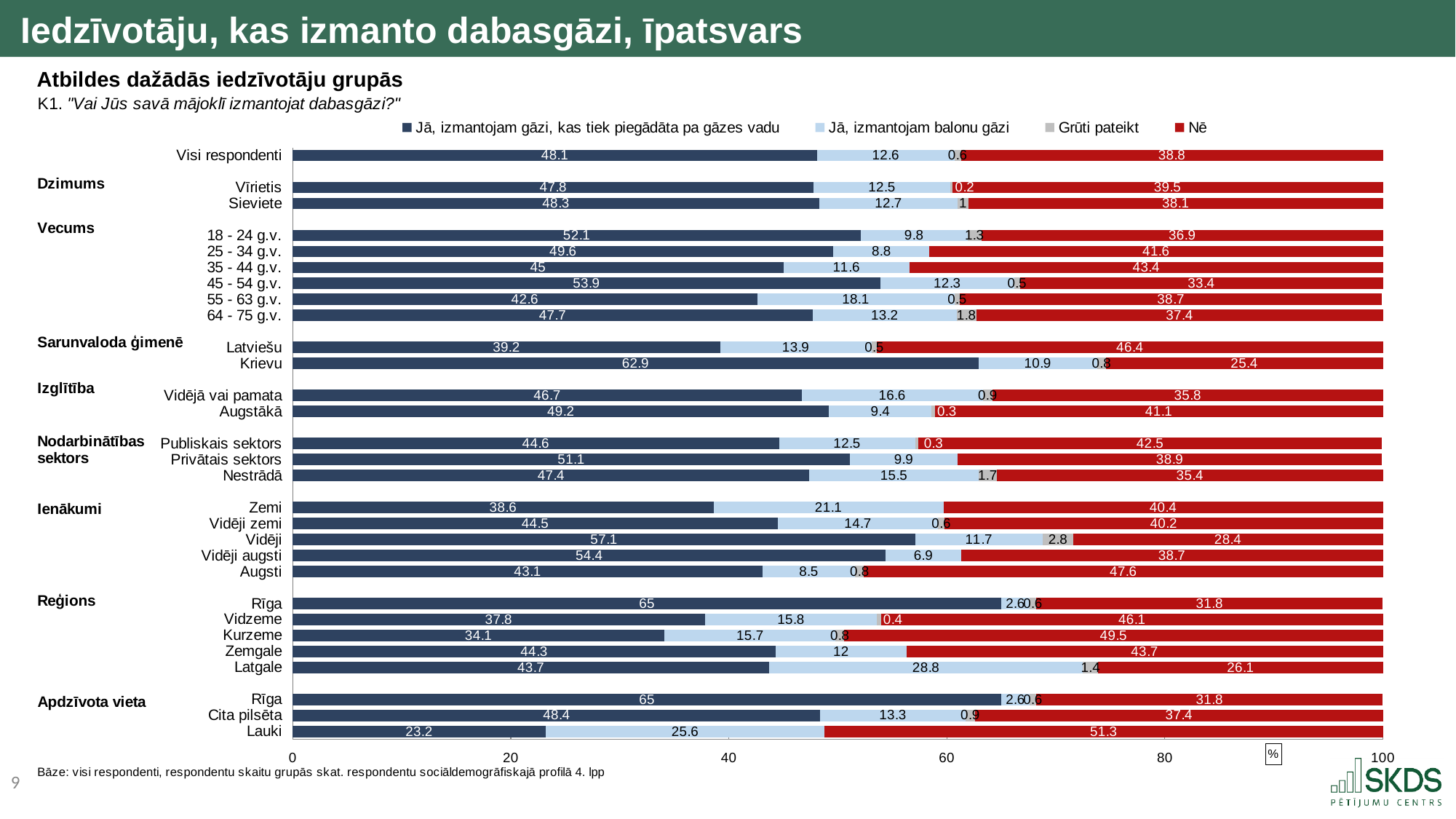
What is the difference between the "Nē" values for Vīrietis and Sieviete? 1.4 What is the "Jā, izmantojam balonu gāzi" value for Latgale? 28.8 Which has a larger piped gas ("gāzes vadu") value, Latviešu or Krievu? Krievu Which category has the highest value for "Jā, izmantojam gāzi, kas tiek piegādāta pa gāzes vadu"? Rīga How many series does the legend list? 4 What is the "Nē" value for the Krievu group? 25.4 What percentage of all respondents (Visi respondenti) answered "Jā, izmantojam gāzi, kas tiek piegādāta pa gāzes vadu"? 48.1 What is the difference between the piped gas ("gāzes vadu") values for Krievu and Latviešu? 23.7 Which category has the lowest value for "Jā, izmantojam gāzi, kas tiek piegādāta pa gāzes vadu"? Lauki What is the "Grūti pateikt" value for the Vidēji income group? 2.8 Which category has the highest "Nē" value? Lauki What kind of chart is shown on the slide? Stacked bar chart